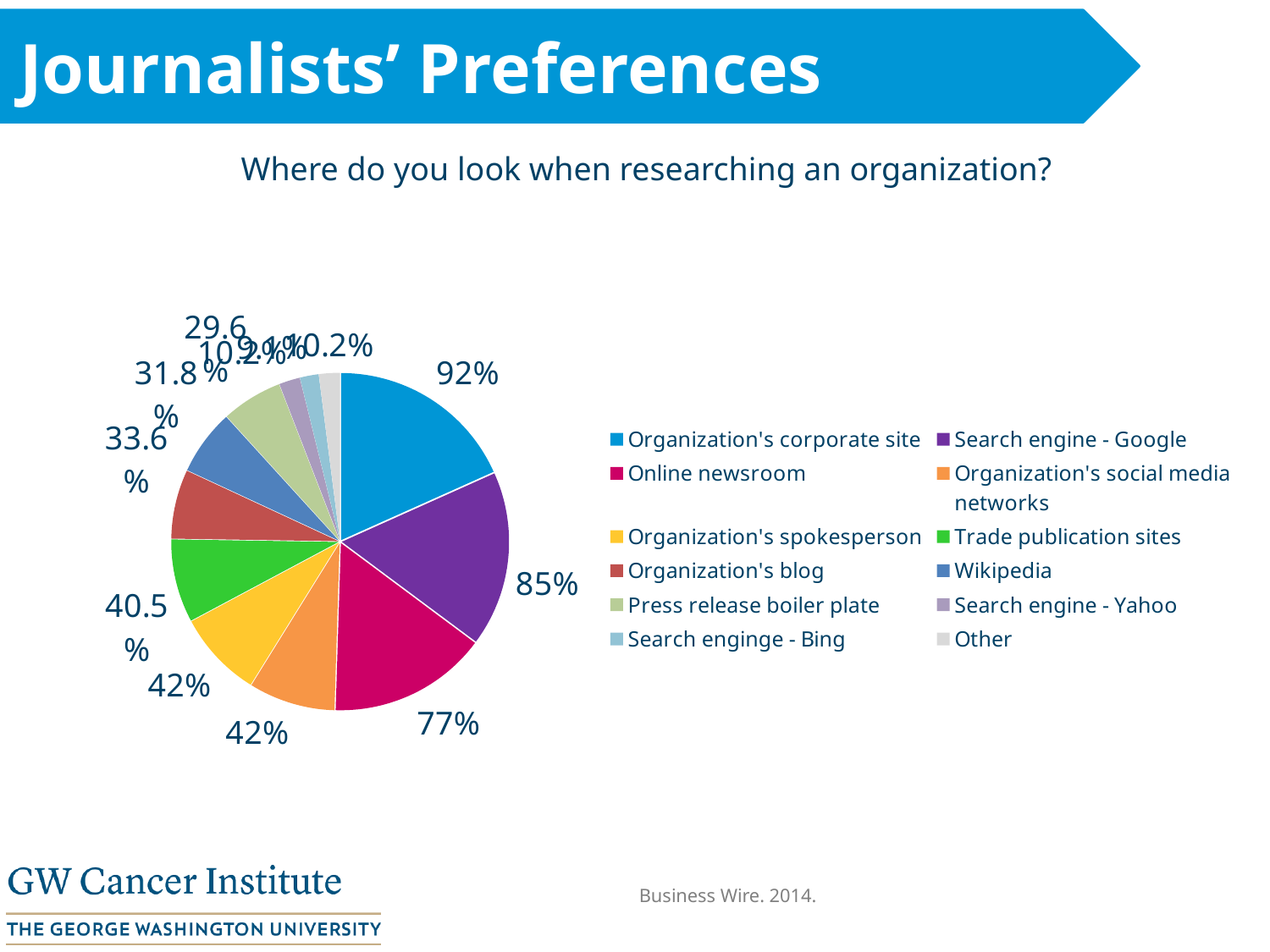
How many categories does the legend of the pie chart list? 12 What is the value shown for Search engine - Google? 85% Which is larger, the value for Search engine - Google or the value for Online newsroom? Search engine - Google What kind of chart is shown on the slide? pie chart What question is the pie chart answering, according to the text above it? Where do you look when researching an organization? What is the difference between the value for Organization's corporate site and the value for Search engine - Google? 7 percentage points What is the value shown for Online newsroom? 77% What is the value shown for Trade publication sites? 40.5% What is the value shown for Organization's blog? 33.6% What is the value shown for Wikipedia? 31.8% What is the value shown for Organization's corporate site? 92% Which category has the largest slice in the pie chart? Organization's corporate site